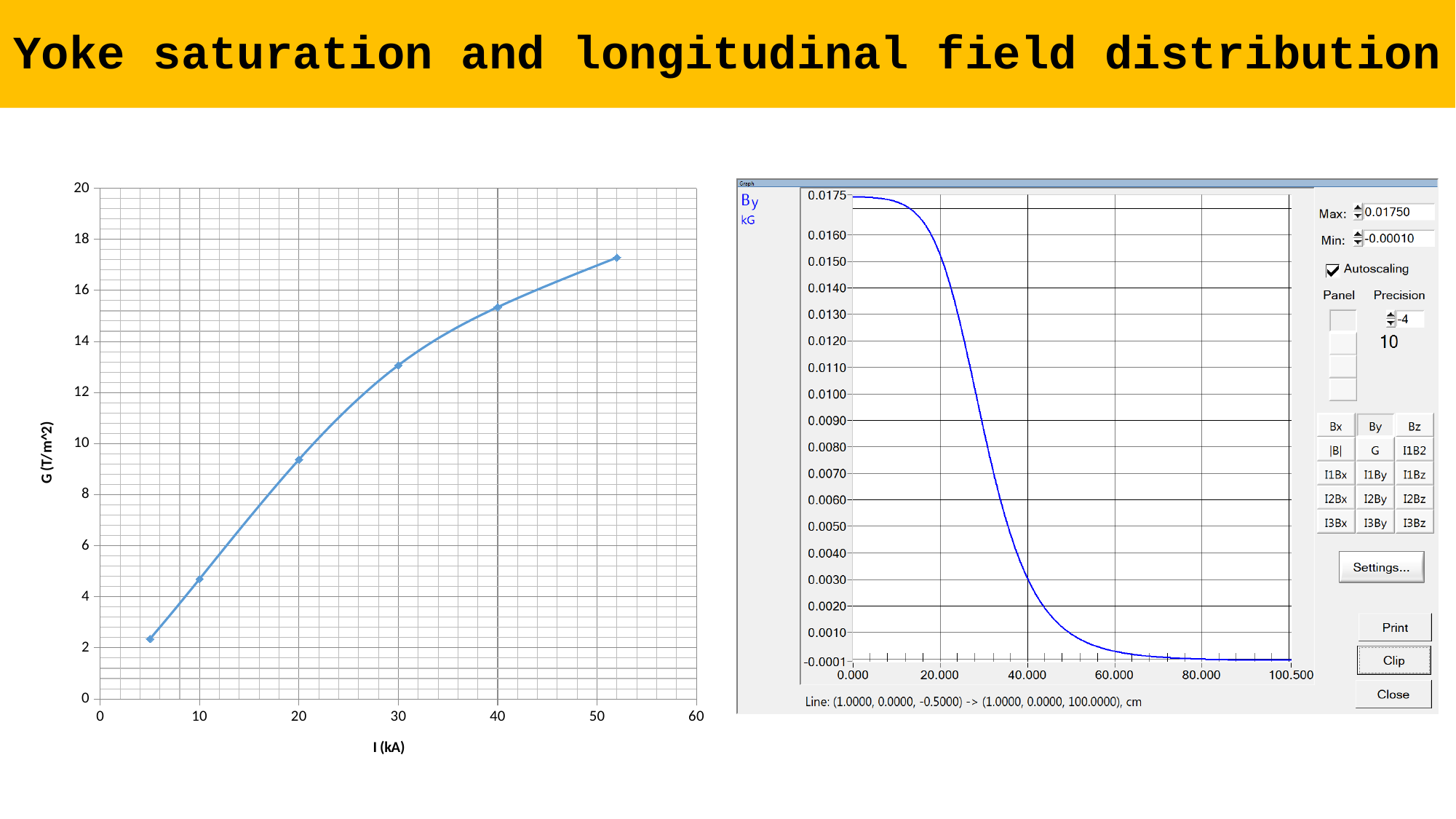
On the left chart, which is larger: G at I = 40 kA or G at I = 20 kA? G at I = 40 kA On the right chart, is the By value at 40.000 greater or less than 0.0040? less On the left chart, how many data points are plotted? 6 On the left chart, do the G values rise or fall as I increases? rise On the left chart, is the value of G at I = 20 kA greater or less than 8? greater On the left chart, is the value of G at I = 10 kA greater or less than 6? less What is the x-axis label of the left chart? I (kA) On the right chart (By vs position), does the By value rise or fall along the x axis? fall On the right chart, what unit is shown for By on the y axis? kG What kind of chart is the left chart (G vs I)? line chart